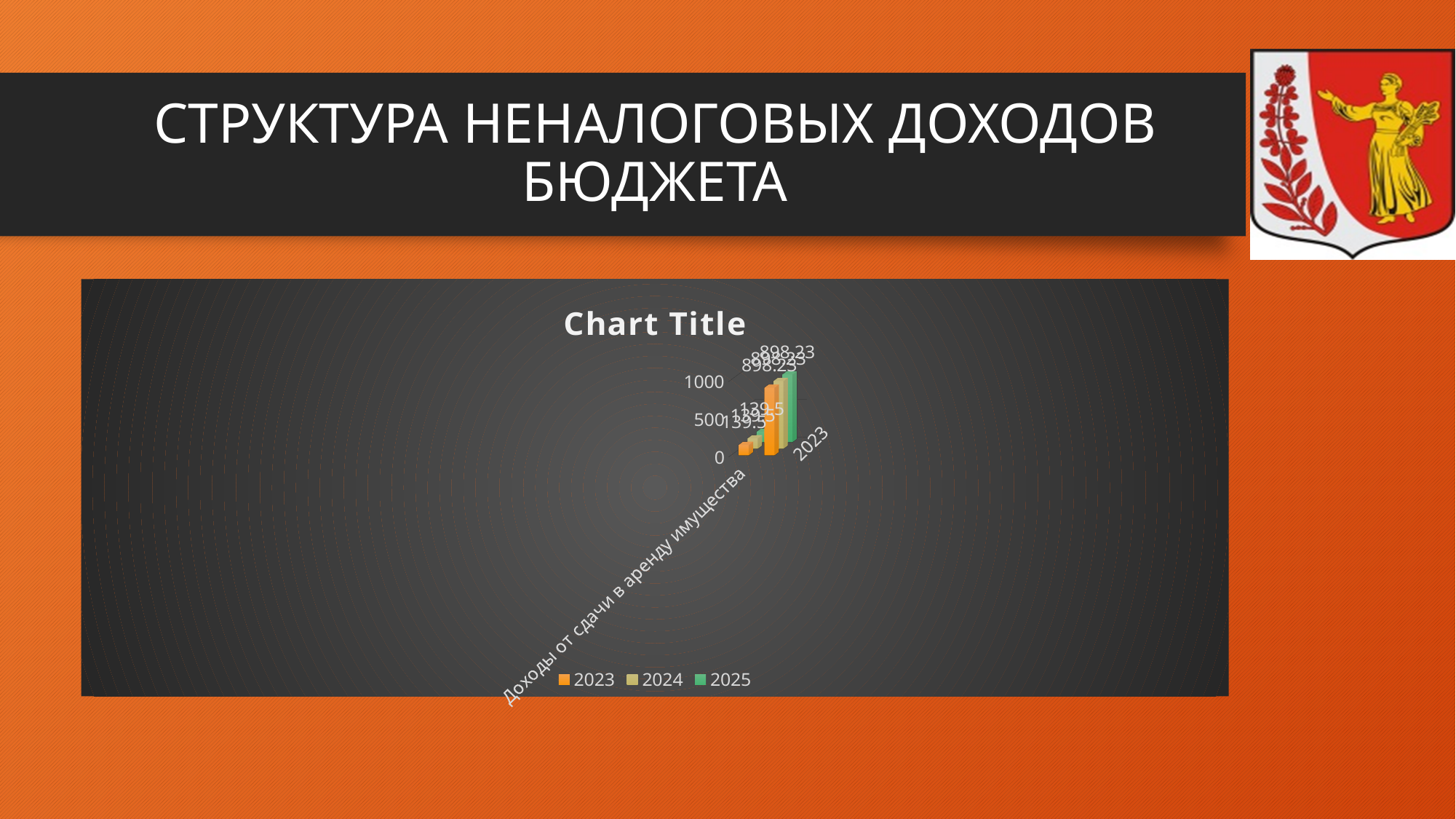
What are the series names listed in the chart legend? 2023, 2024, 2025 What kind of chart is shown on the slide? bar chart How many series does the chart legend list? 3 What is the lowest data label value shown on the chart? 139.5 What is the highest tick value shown on the chart's value axis? 1000 Is the data label 139.5 greater or less than 500 on the value axis? less Is the data label 898.23 greater or less than 500 on the value axis? greater What is the highest data label value shown on the chart? 898.23 What is the title printed above the chart? Chart Title Which is larger, the data label 898.23 or the data label 139.5? 898.23